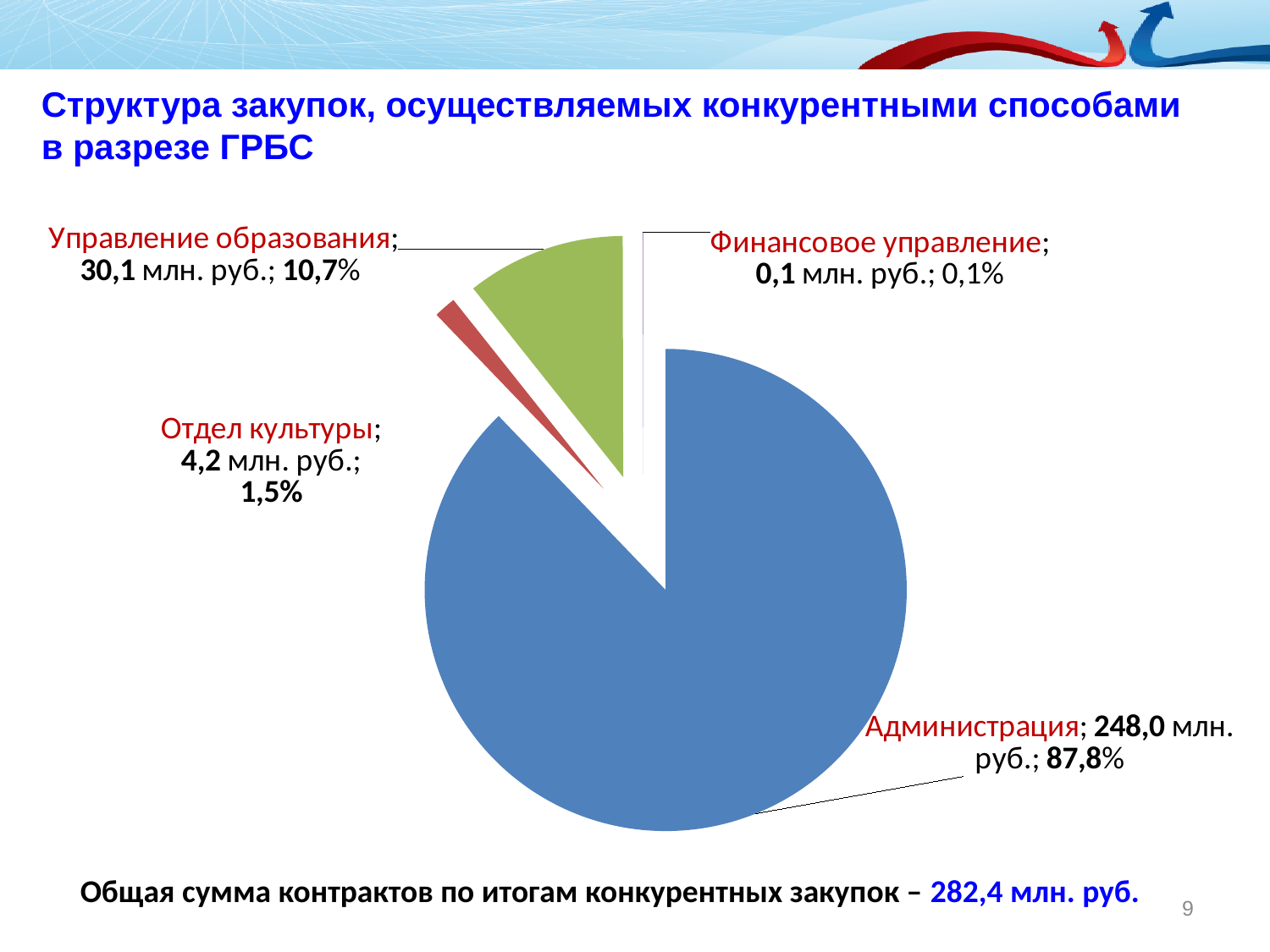
Which is larger, the value for Отдел культуры or the value for Финансовое управление? Отдел культуры What share of the pie does Управление образования account for? 10,7% What is the difference in млн. руб. between Управление образования and Отдел культуры? 25,9 млн. руб. How many slices does the pie chart have? 4 Which category has the smallest slice of the pie? Финансовое управление What is the value for Отдел культуры in млн. руб.? 4,2 млн. руб. What share of the pie does Администрация account for? 87,8% What is the value for Администрация in млн. руб.? 248,0 млн. руб. Which category has the largest slice of the pie? Администрация What is the value for Управление образования in млн. руб.? 30,1 млн. руб. What kind of chart is shown on the slide? Pie chart What is the value for Финансовое управление in млн. руб.? 0,1 млн. руб.